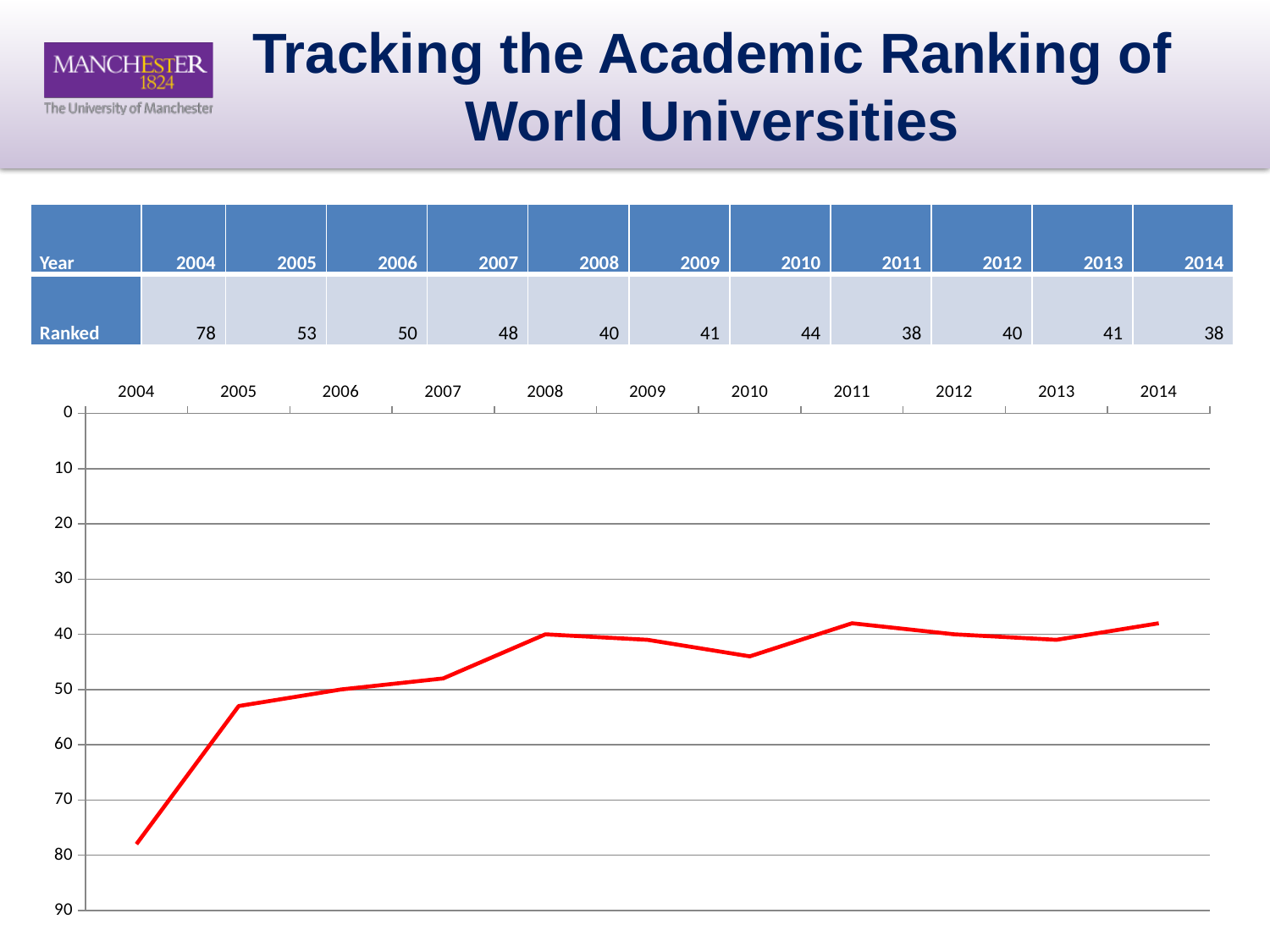
Which year has the larger ranked value, 2010 or 2011? 2010 Do the ranked values rise or fall from 2004 to 2008? fall How many years are plotted on the chart? 11 Which year has the largest ranked value? 2004 What is the difference between the ranked values for 2004 and 2005? 25 What is the ranked value for 2004? 78 What is the difference between the ranked values for 2010 and 2011? 6 Is the value for 2004 greater or less than 70? greater What is the ranked value for 2010? 44 What is the ranked value for 2014? 38 What kind of chart is shown on the slide? line chart What is the lowest ranked value shown? 38